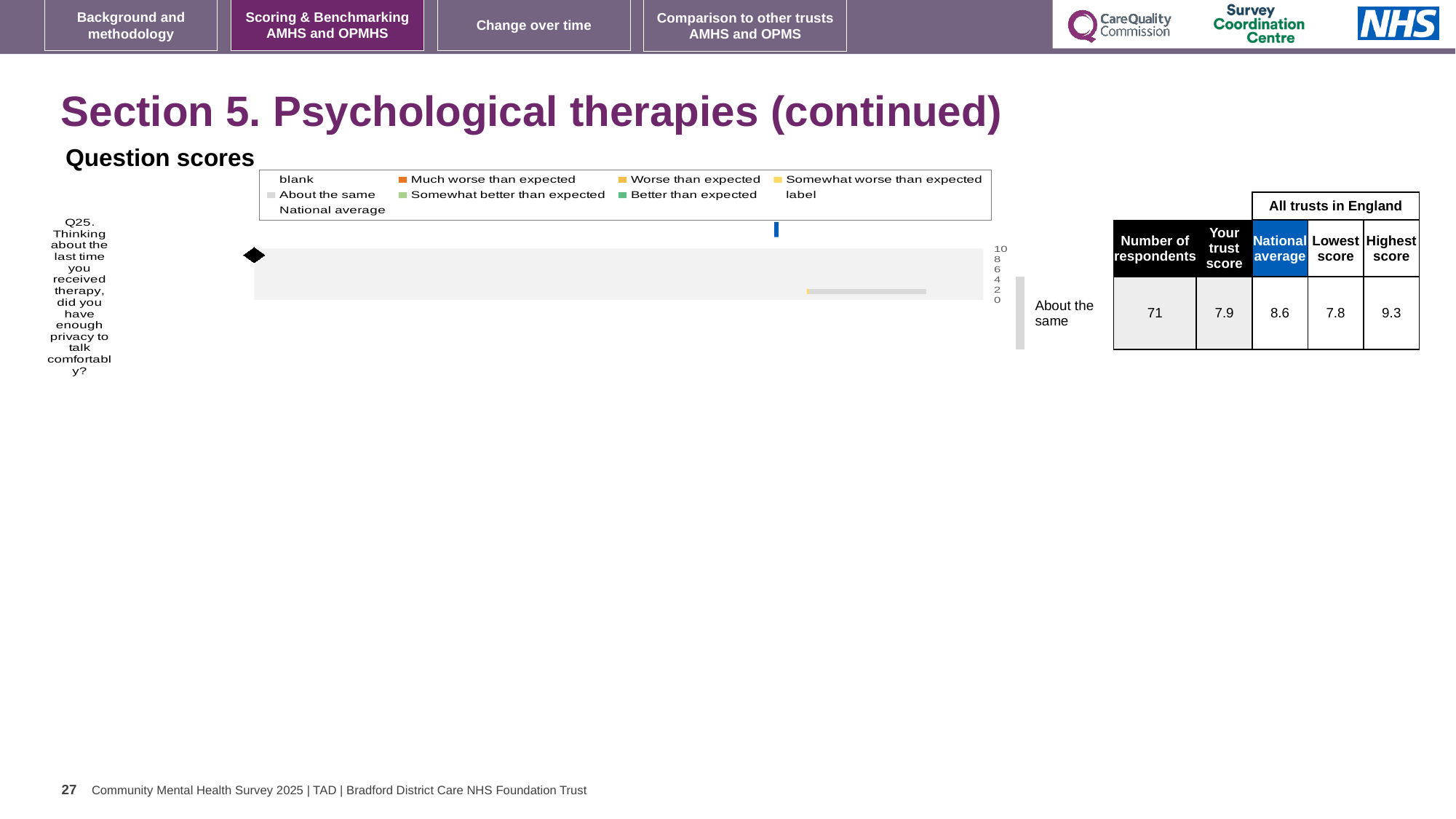
What is the difference between the highest score and the lowest score among all trusts in England for Q25? 1.5 In the table beside the chart, what is the number of respondents for Q25? 71 Which question number is plotted in the question scores chart? Q25 In the table beside the chart, what is the highest score among all trusts in England for Q25? 9.3 In the table beside the chart, what is the lowest score among all trusts in England for Q25? 7.8 In the table beside the chart, what is the national average score for Q25? 8.6 What benchmark category is shown next to the chart for Q25? About the same What is the highest value shown on the score axis of the chart? 10 What kind of chart is used to show the question scores? bar chart How many questions are plotted in the question scores chart? 1 In the table beside the chart, what is the trust's score for Q25? 7.9 Is the trust's score for Q25 higher or lower than the national average? lower